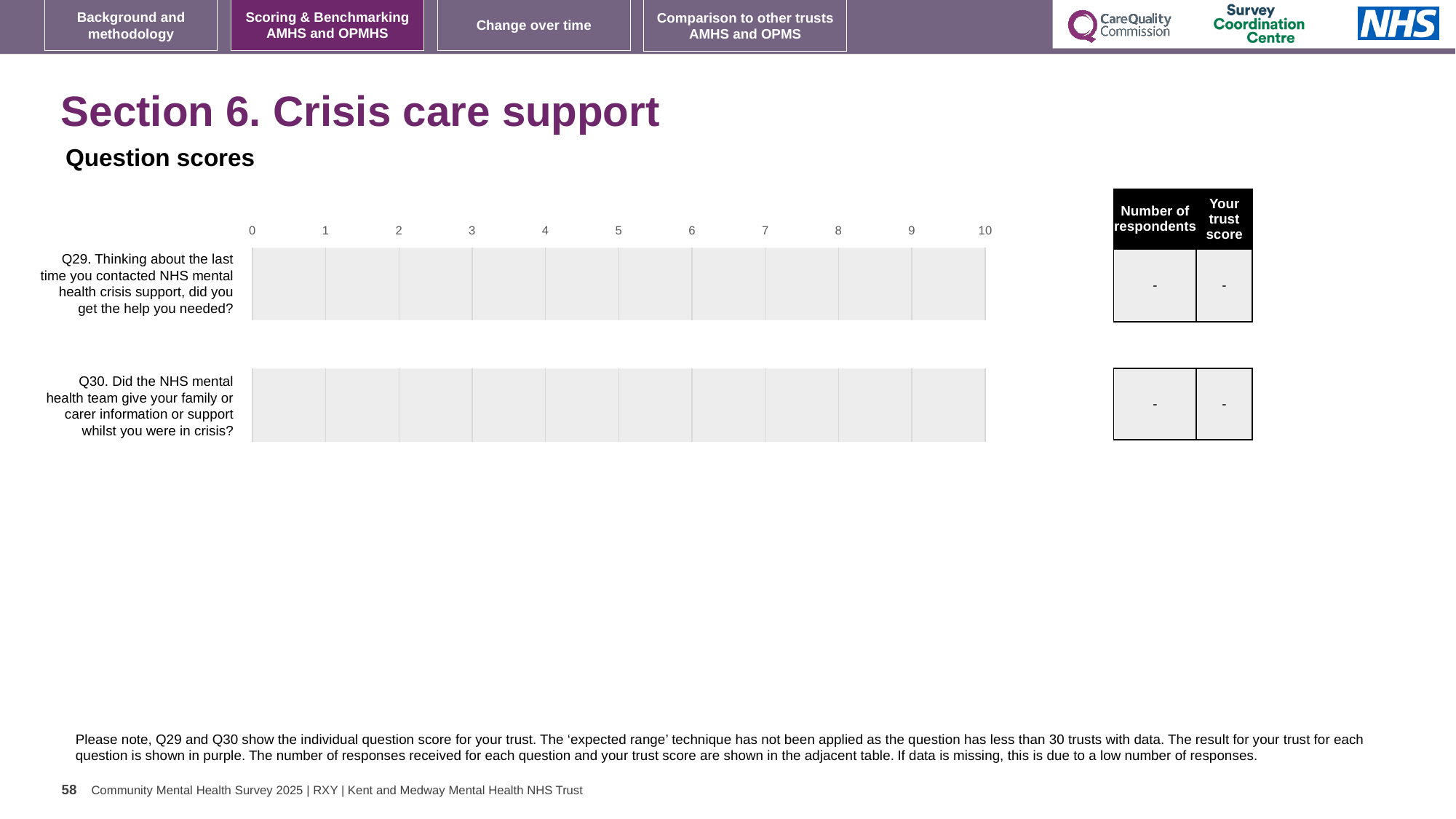
Which question number is listed first on the chart? Q29 How many questions (categories) are shown on the chart? 2 What is the lowest value shown on the chart's horizontal axis? 0 What is shown in the 'Number of respondents' column for Q29? - What is the highest value shown on the chart's horizontal axis? 10 What is shown in the 'Your trust score' column for Q30? - What kind of chart is shown on the slide? bar chart Which question number is listed second on the chart? Q30